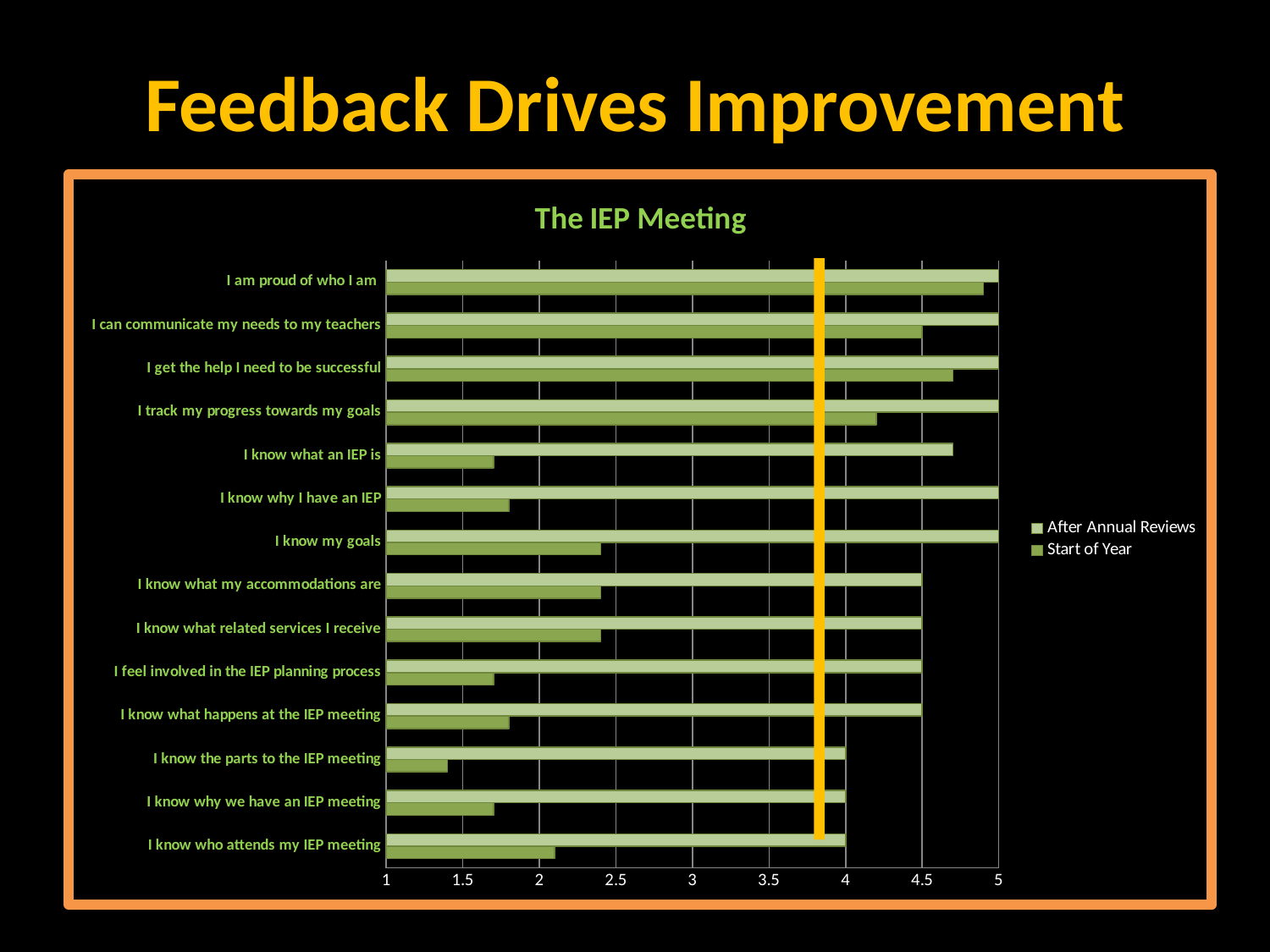
What is the After Annual Reviews value for "I am proud of who I am"? 5 Which category has the lowest Start of Year value? I know the parts to the IEP meeting How many series does the legend list? 2 What is the title of the chart? The IEP Meeting Is the After Annual Reviews value for "I know what my accommodations are" greater or less than 4? greater Is the Start of Year value for "I know what an IEP is" greater or less than 2? less What kind of chart is shown on the slide? bar chart What is the After Annual Reviews value for "I know the parts to the IEP meeting"? 4 For Start of Year, which is larger: "I know my goals" or "I know what an IEP is"? I know my goals What is the difference between the After Annual Reviews values for "I am proud of who I am" and "I know the parts to the IEP meeting"? 1 Which category has the highest Start of Year value? I am proud of who I am How many categories (statements) are plotted on the chart? 14